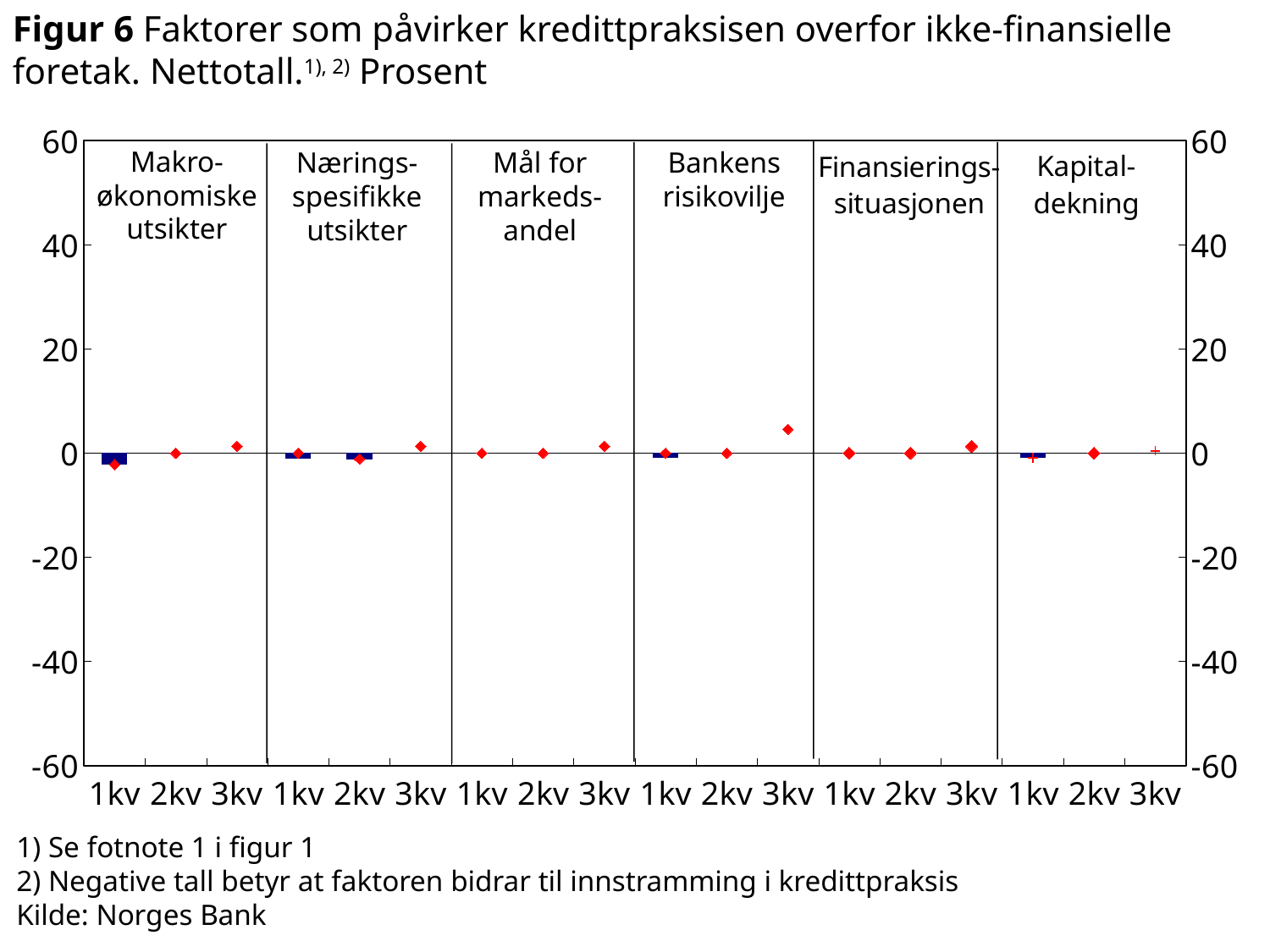
Is the value for 'Næringsspesifikke utsikter' in 2kv greater or less than -20? greater Is the value for 'Bankens risikovilje' in 3kv greater or less than 20? less How many quarters (1kv, 2kv, 3kv) are shown within each factor panel? 3 Is the red diamond for 'Bankens risikovilje' in 3kv higher or lower than the red diamond for 'Finansieringssituasjonen' in 3kv? higher What is the lowest value shown on the vertical axis? -60 How many factor panels does the chart have? 6 What is the highest value shown on the vertical axis? 60 Is the value for 'Makroøkonomiske utsikter' in 1kv greater or less than -20? greater Which factor is labelled in the fourth panel from the left? Bankens risikovilje What kind of chart is shown on the slide? bar chart with red diamond markers (combination bar and line chart) Which factor panel contains the highest red diamond marker? Bankens risikovilje